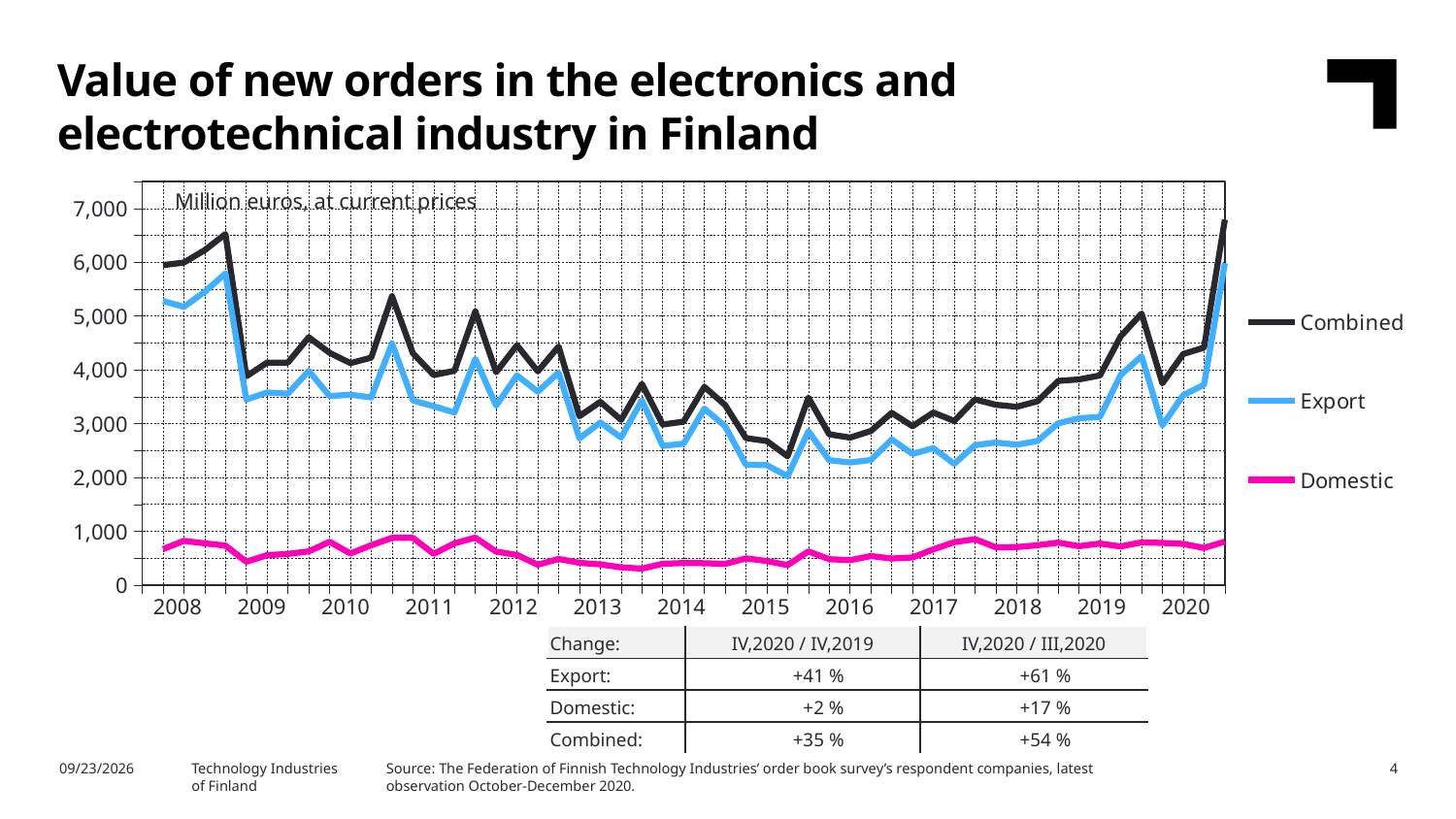
Do the Combined values rise or fall from 2008 to 2016? fall How many series does the legend list? 3 Which series has the highest values throughout the chart? Combined Is the value for Combined at the end of 2020 greater or less than 6,000? greater Is the value for Export at the start of 2008 greater or less than 5,000? greater Is the value for Domestic in 2008 greater or less than 1,000? less Which is larger in 2012, the Export value or the Domestic value? Export How many year labels are shown on the x axis? 13 What unit is stated in the label at the top of the chart? Million euros, at current prices Which series has the lowest values throughout the chart? Domestic What kind of chart is shown on the slide? line chart